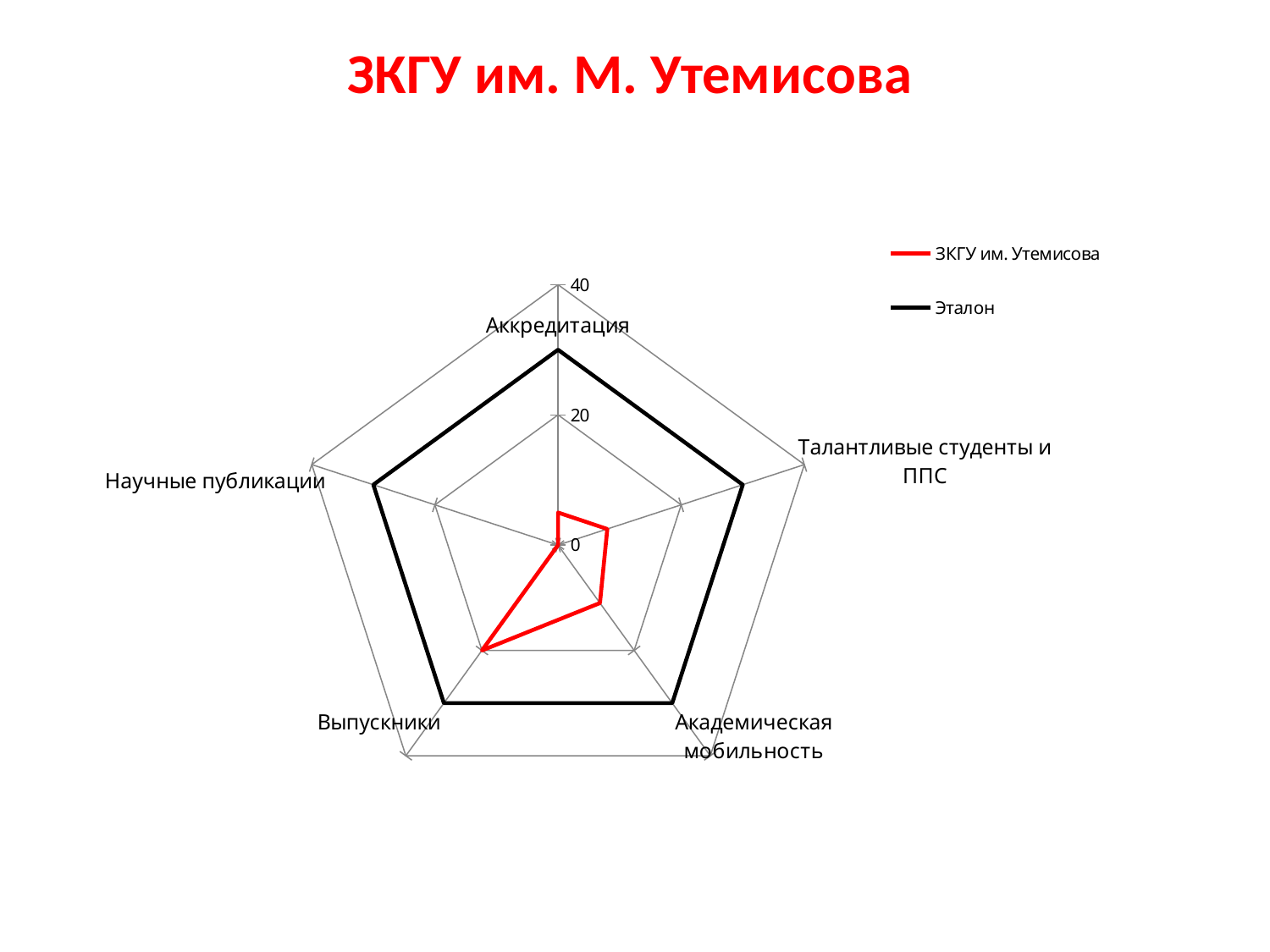
For the ЗКГУ им. Утемисова series, which category has the highest value? Выпускники For Талантливые студенты и ППС, which series has the larger value, ЗКГУ им. Утемисова or Эталон? Эталон Is the Эталон value for Выпускники greater or less than 40? less Is the Эталон value for Аккредитация greater or less than 20? greater Which series is drawn in red in the chart? ЗКГУ им. Утемисова For the ЗКГУ им. Утемисова series, which category has the lowest value? Научные публикации Is the ЗКГУ им. Утемисова value for Академическая мобильность greater or less than 20? less What is the title of the slide? ЗКГУ им. М. Утемисова What kind of chart is shown on the slide? Radar chart How many series does the legend list? 2 How many categories (axes) does the radar chart have? 5